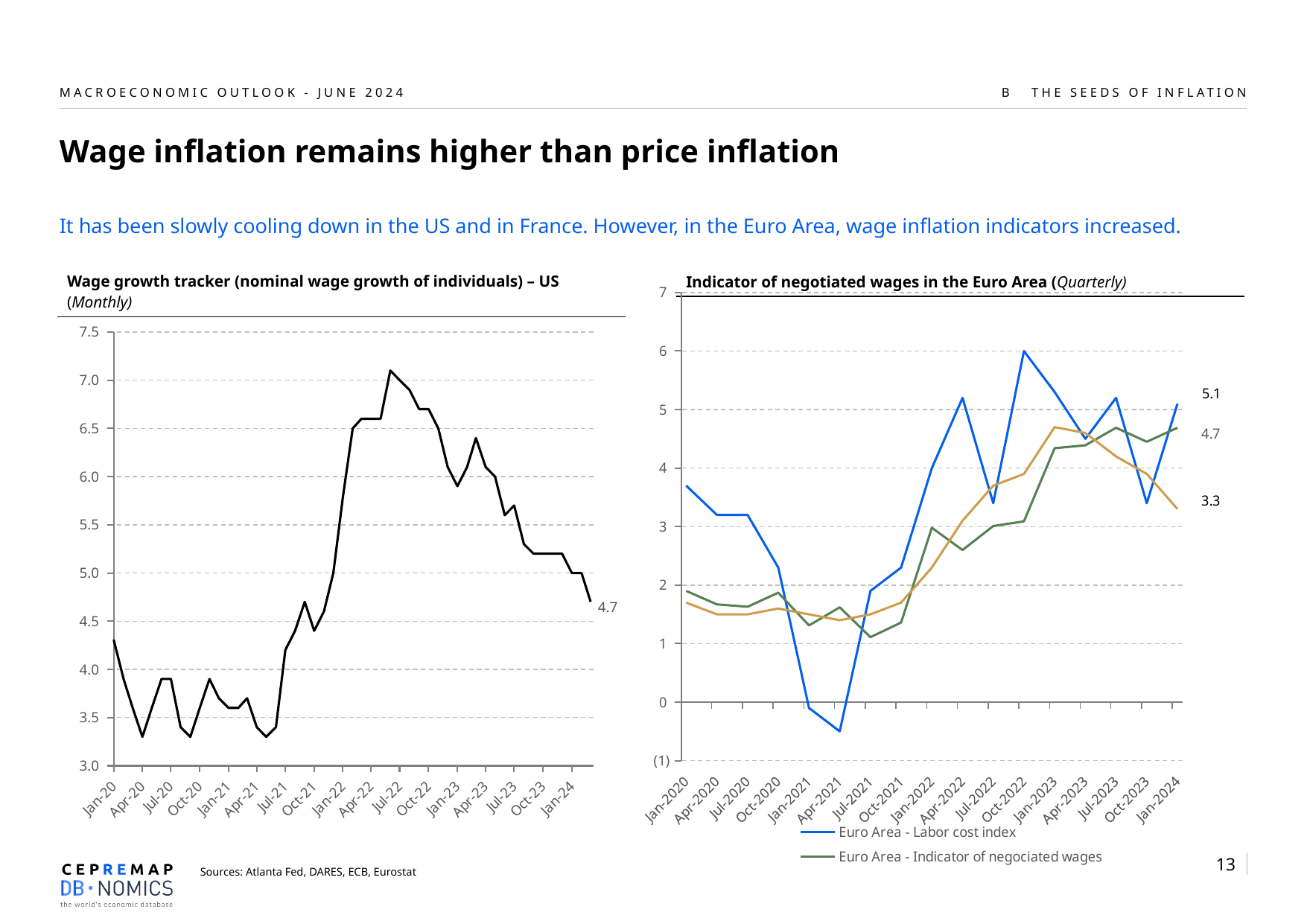
In the Euro Area chart, what is the difference between the final labelled values of the Labor cost index (5.1) and the Indicator of negotiated wages (4.7)? 0.4 How many series does the legend of the 'Indicator of negotiated wages in the Euro Area' chart list? 2 What kind of chart is the 'Wage growth tracker (nominal wage growth of individuals) – US' chart? line chart In the 'Indicator of negotiated wages in the Euro Area' chart, what is the final labelled value of the Euro Area - Indicator of negotiated wages series? 4.7 In the Euro Area chart, is the Labor cost index at Apr-2021 greater or less than 0? less In the Euro Area chart, in which quarter does the Labor cost index reach its highest value? Oct-2022 In the US wage growth tracker chart, what is the value labelled at the end of the line (Jan-24)? 4.7 In the US wage growth tracker chart, does the line rise or fall between Jul-22 and Jan-24? fall In the Euro Area chart, which series ends higher at Jan-2024: the Labor cost index or the Indicator of negotiated wages? Euro Area - Labor cost index In the US wage growth tracker chart, is the value at Jan-20 greater or less than 4.0? greater In the 'Indicator of negotiated wages in the Euro Area' chart, what is the final labelled value of the Euro Area - Labor cost index series? 5.1 What is the title of the chart on the left of the slide? Wage growth tracker (nominal wage growth of individuals) – US (Monthly)